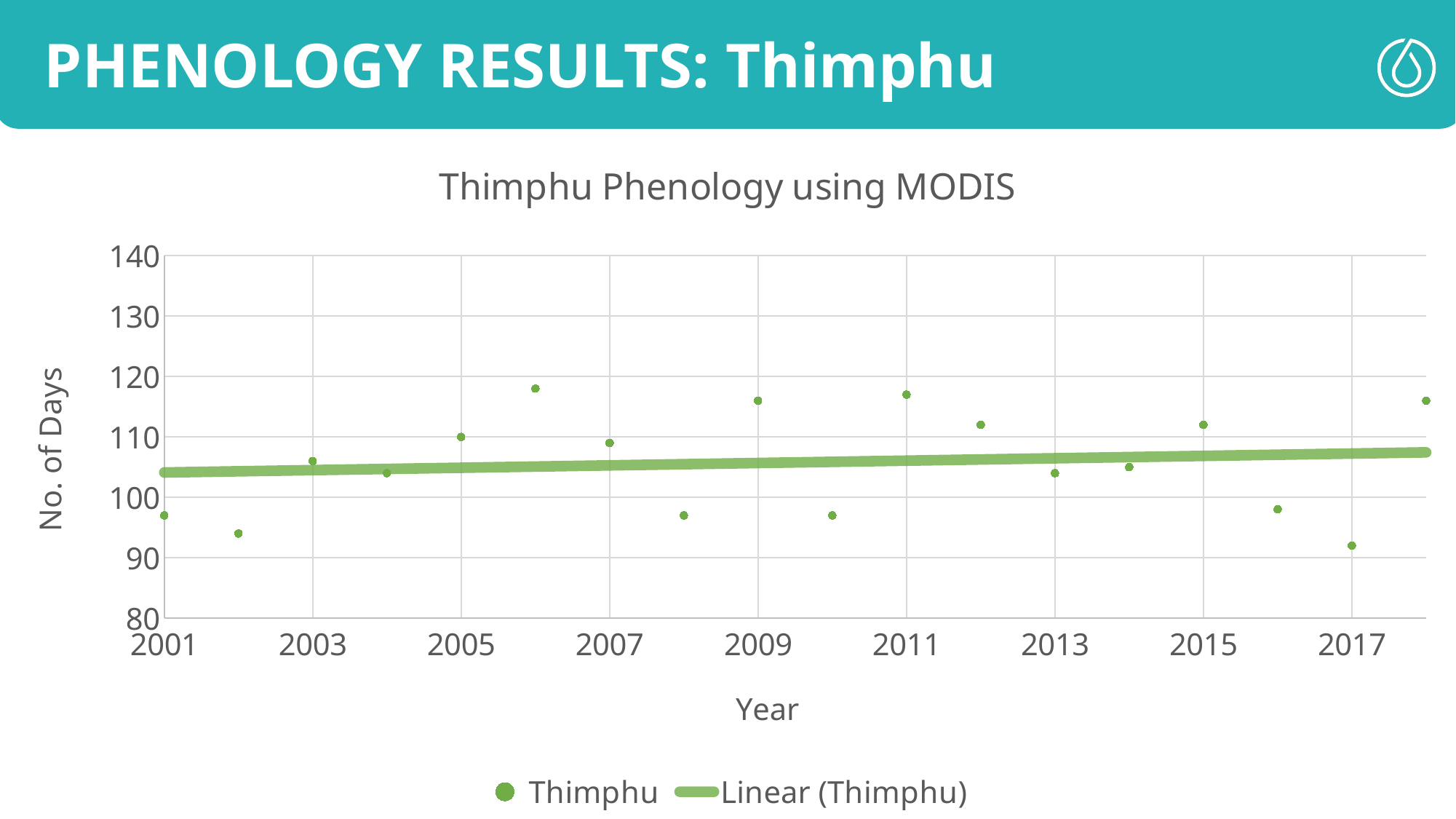
Is the value for 2009 greater or less than 110? greater Is the value for 2017 greater or less than 100? less Is the value for 2006 greater or less than 110? greater How many entries does the chart legend list? 2 Does the linear trendline for Thimphu rise or fall from 2001 to 2018? rise Which year has the larger value, 2006 or 2017? 2006 What kind of chart is shown on the slide? Scatter chart How many data points are plotted for Thimphu? 18 What is the label of the vertical axis? No. of Days What is the title of the chart? Thimphu Phenology using MODIS